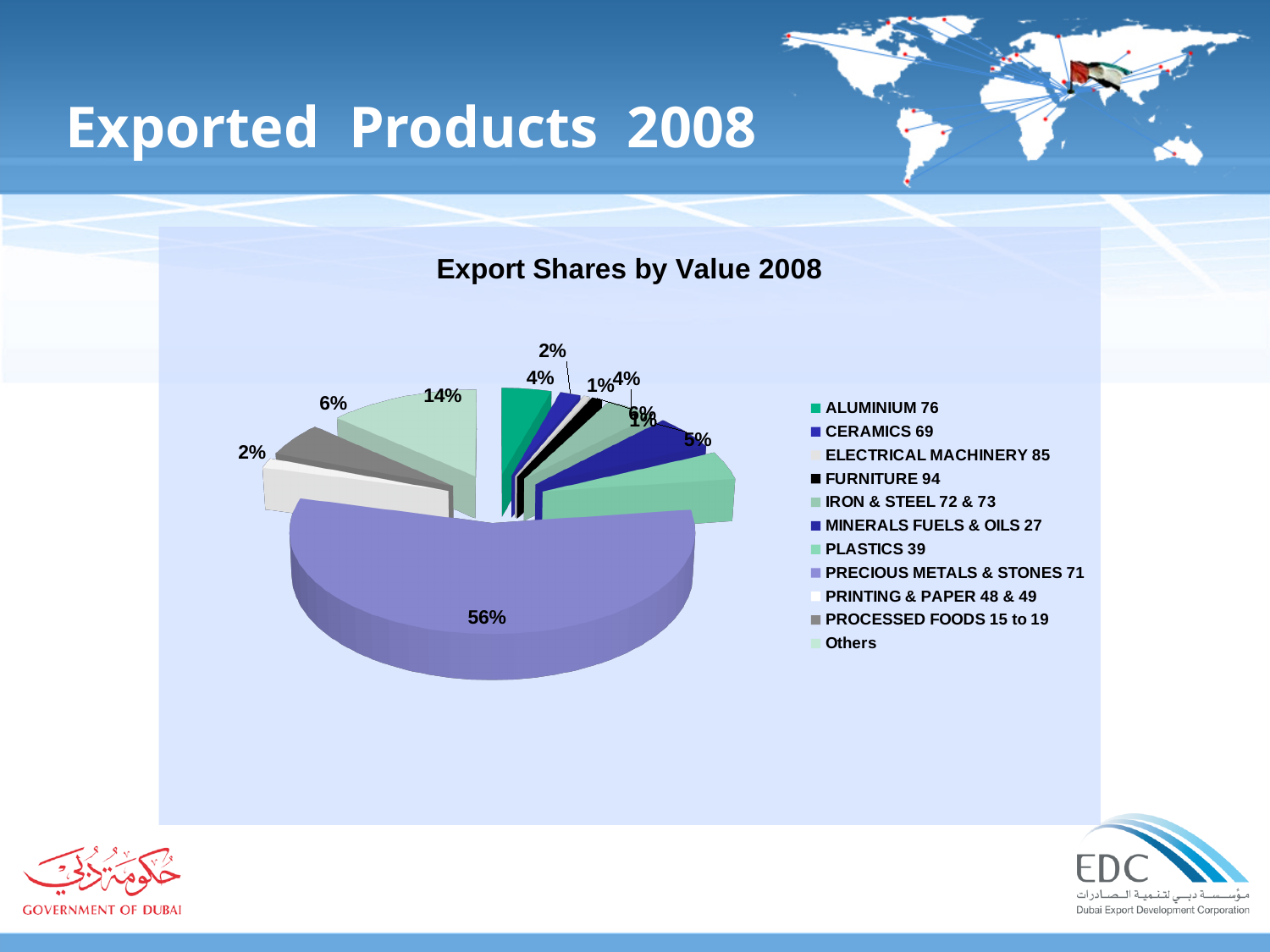
What is the value shown for PRINTING & PAPER 48 & 49? 2% What is the value shown for PLASTICS 39? 5% How many categories does the legend of the pie chart list? 11 What colour is the slice for PRECIOUS METALS & STONES 71? purple What share of the pie does PRECIOUS METALS & STONES 71 have? 56% Which category has the largest share of the pie? PRECIOUS METALS & STONES 71 What is the value shown for PROCESSED FOODS 15 to 19? 6% What kind of chart is shown on the slide? pie chart What is the difference between the share for PRECIOUS METALS & STONES 71 and the share for Others? 42% Which is larger, the share for Others or the share for PROCESSED FOODS 15 to 19? Others What share of the pie does the Others category have? 14% What is the title of the chart? Export Shares by Value 2008